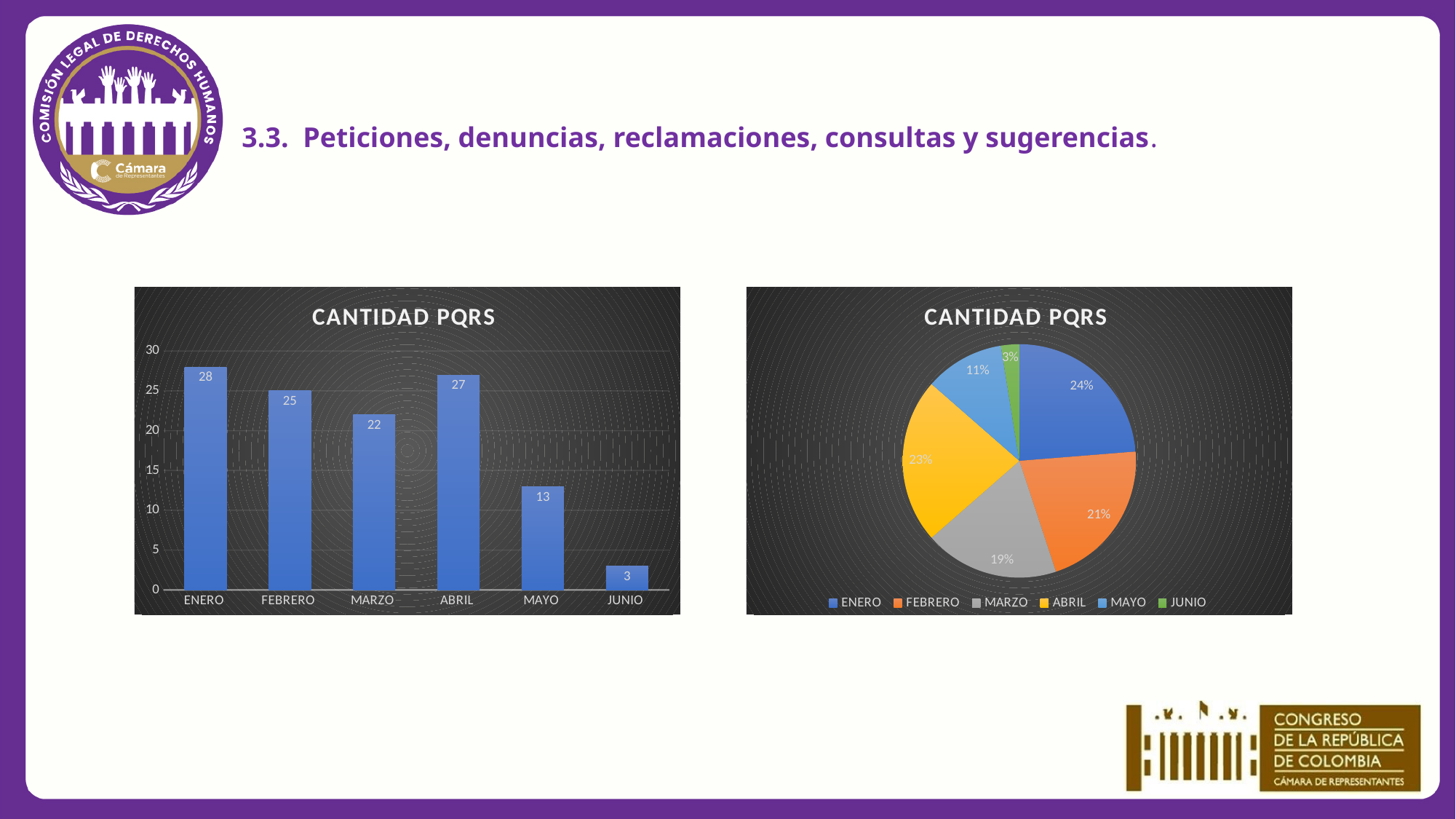
In the pie chart on the right, what share does ABRIL have? 23% In the bar chart on the left, which month has the highest value? ENERO In the bar chart on the left, how many months are shown on the x axis? 6 In the bar chart on the left, which is larger, the value for FEBRERO or the value for MAYO? FEBRERO What kind of chart is the chart on the left? bar chart In the bar chart on the left, what is the value for ENERO? 28 In the pie chart on the right, how many entries does the legend list? 6 In the bar chart on the left, which month has the lowest value? JUNIO In the pie chart on the right, what share does JUNIO have? 3% What kind of chart is the chart on the right? pie chart In the bar chart on the left, what is the difference between the values for ABRIL and MARZO? 5 In the bar chart on the left, what is the value for MAYO? 13